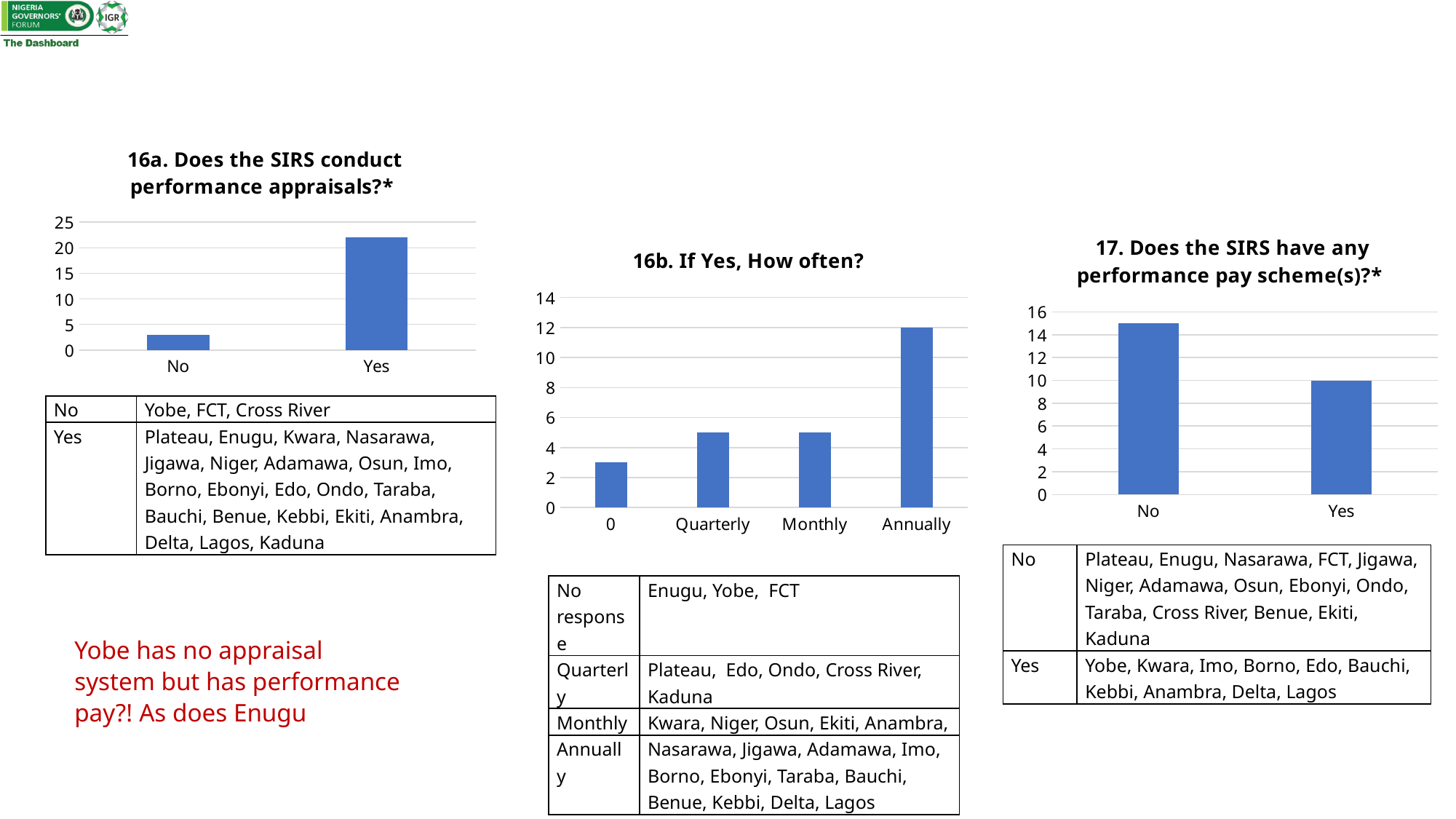
In the chart titled '17. Does the SIRS have any performance pay scheme(s)?*', what is the value for Yes? 10 In the chart titled '16b. If Yes, How often?', which category has the highest value? Annually In the chart titled '16b. If Yes, How often?', what is the value for Annually? 12 In the chart titled '16a. Does the SIRS conduct performance appraisals?*', which category has the highest value? Yes In the chart titled '16b. If Yes, How often?', is the value for Quarterly greater or less than 4? greater What kind of chart is '16b. If Yes, How often?'? bar chart How many categories are shown in the chart titled '16b. If Yes, How often?'? 4 In the chart titled '17. Does the SIRS have any performance pay scheme(s)?*', is the value for No greater or less than 14? greater In the chart titled '16a. Does the SIRS conduct performance appraisals?*', is the value for Yes greater or less than 20? greater In the chart titled '17. Does the SIRS have any performance pay scheme(s)?*', which category has the lowest value? Yes How many categories are shown in the chart titled '16a. Does the SIRS conduct performance appraisals?*'? 2